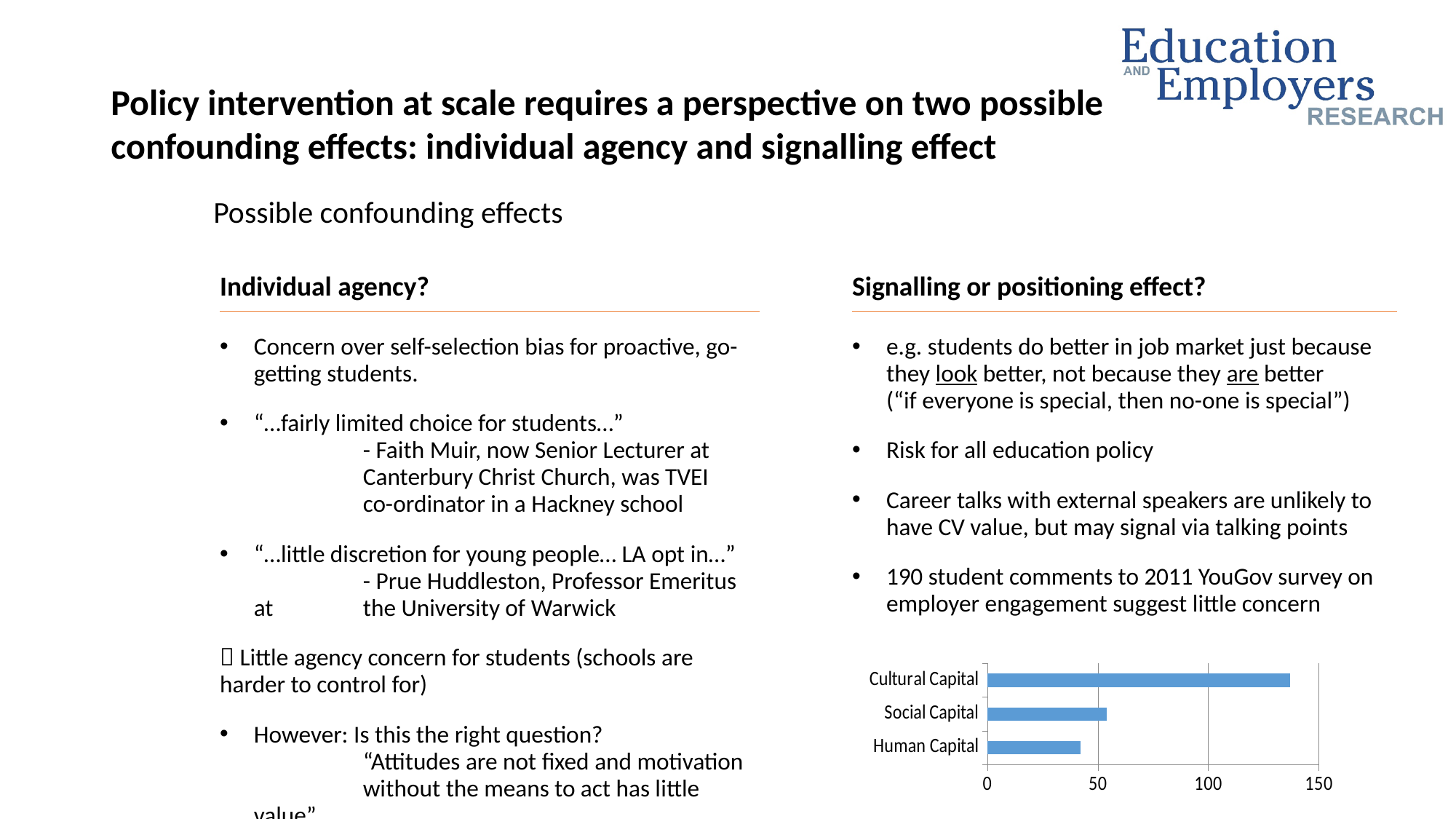
Which category is listed at the top of the bar chart? Cultural Capital Which is larger in the bar chart, Cultural Capital or Social Capital? Cultural Capital What kind of chart is shown at the bottom right of the slide? bar chart Which category has the lowest value in the bar chart? Human Capital How many categories does the bar chart show? 3 Which is larger in the bar chart, Social Capital or Human Capital? Social Capital Is the value for Social Capital greater or less than 100? less Is the value for Cultural Capital greater or less than 100? greater Is the value for Human Capital greater or less than 50? less What is the highest tick value shown on the horizontal axis of the bar chart? 150 Which category has the highest value in the bar chart? Cultural Capital